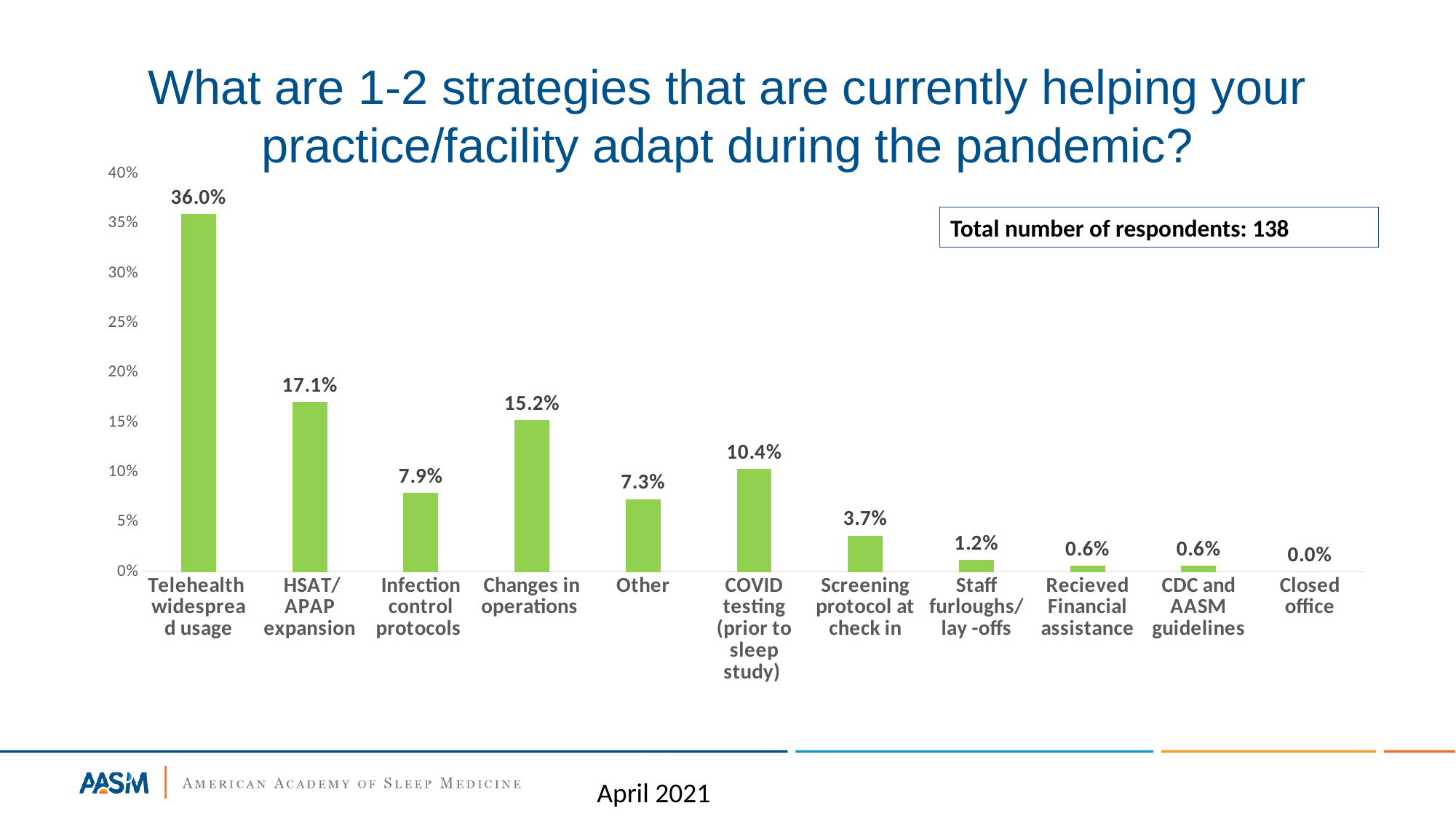
What kind of chart is shown on the slide? bar chart Which category has the lowest value? Closed office What percentage of respondents selected Telehealth widespread usage? 36.0% What is the value for COVID testing (prior to sleep study)? 10.4% What is the total number of respondents stated on the slide? 138 What is the difference between Telehealth widespread usage and HSAT/APAP expansion? 18.9% What is the difference between HSAT/APAP expansion and Changes in operations? 1.9% What is the value for Staff furloughs/lay-offs? 1.2% How many categories are shown on the x axis? 11 Which strategy has the highest percentage? Telehealth widespread usage Which is larger: Infection control protocols or Other? Infection control protocols Is the value for Changes in operations greater or less than 20%? less